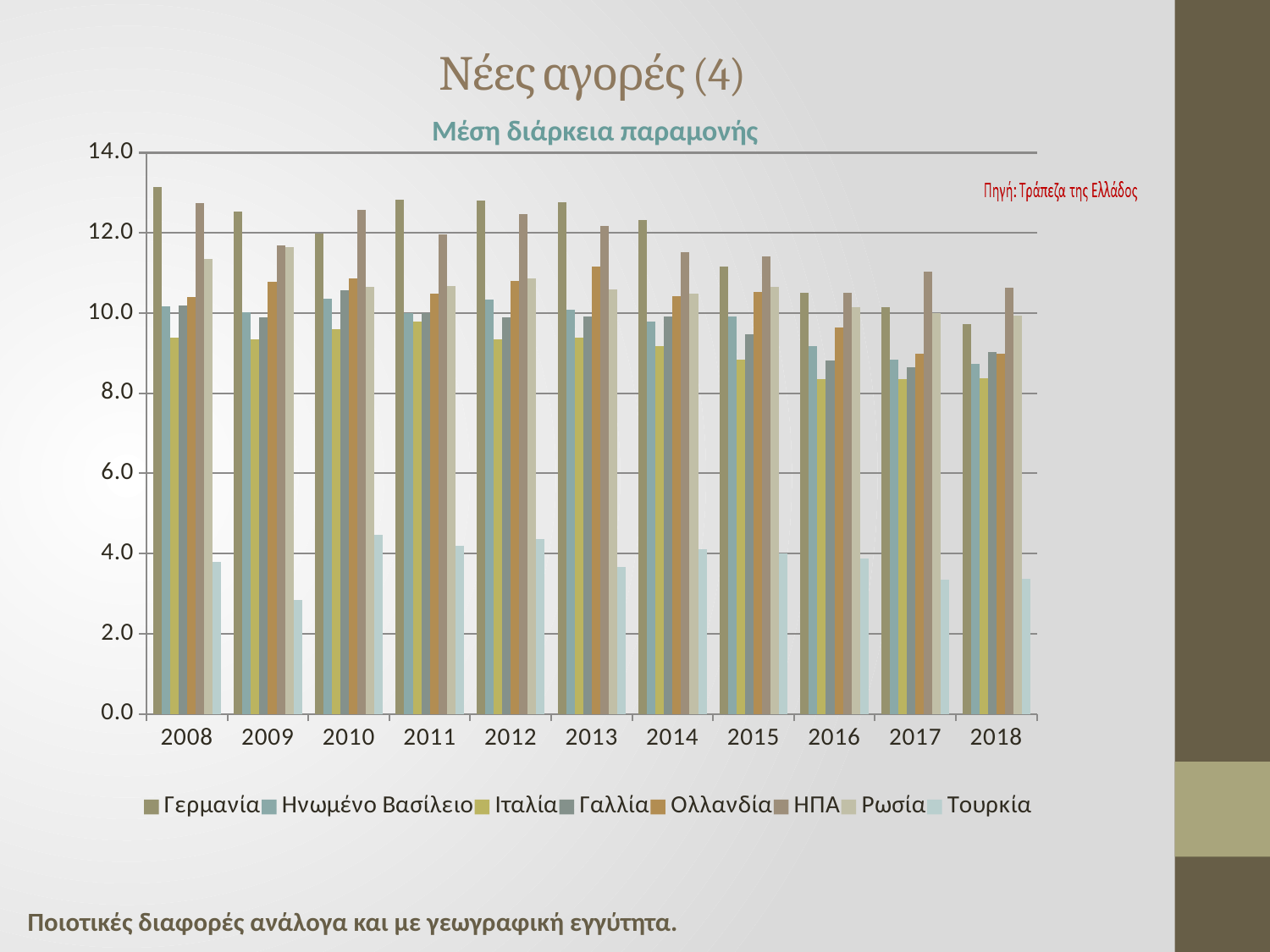
What is the title of the chart? Μέση διάρκεια παραμονής What kind of chart is shown on the slide? bar chart How many series does the chart's legend list? 8 Is the value for Ολλανδία in 2017 greater or less than 10.0? less Is the value for Τουρκία in 2009 greater or less than 4.0? less Is the value for Γερμανία in 2008 greater or less than 12.0? greater Which country has the lowest value in 2008? Τουρκία Which is larger in 2017, the value for ΗΠΑ or the value for Ηνωμένο Βασίλειο? ΗΠΑ How many years are shown along the x axis of the chart? 11 Which country has the highest value in 2008? Γερμανία Does the value for Γερμανία rise or fall overall from 2008 to 2018? fall